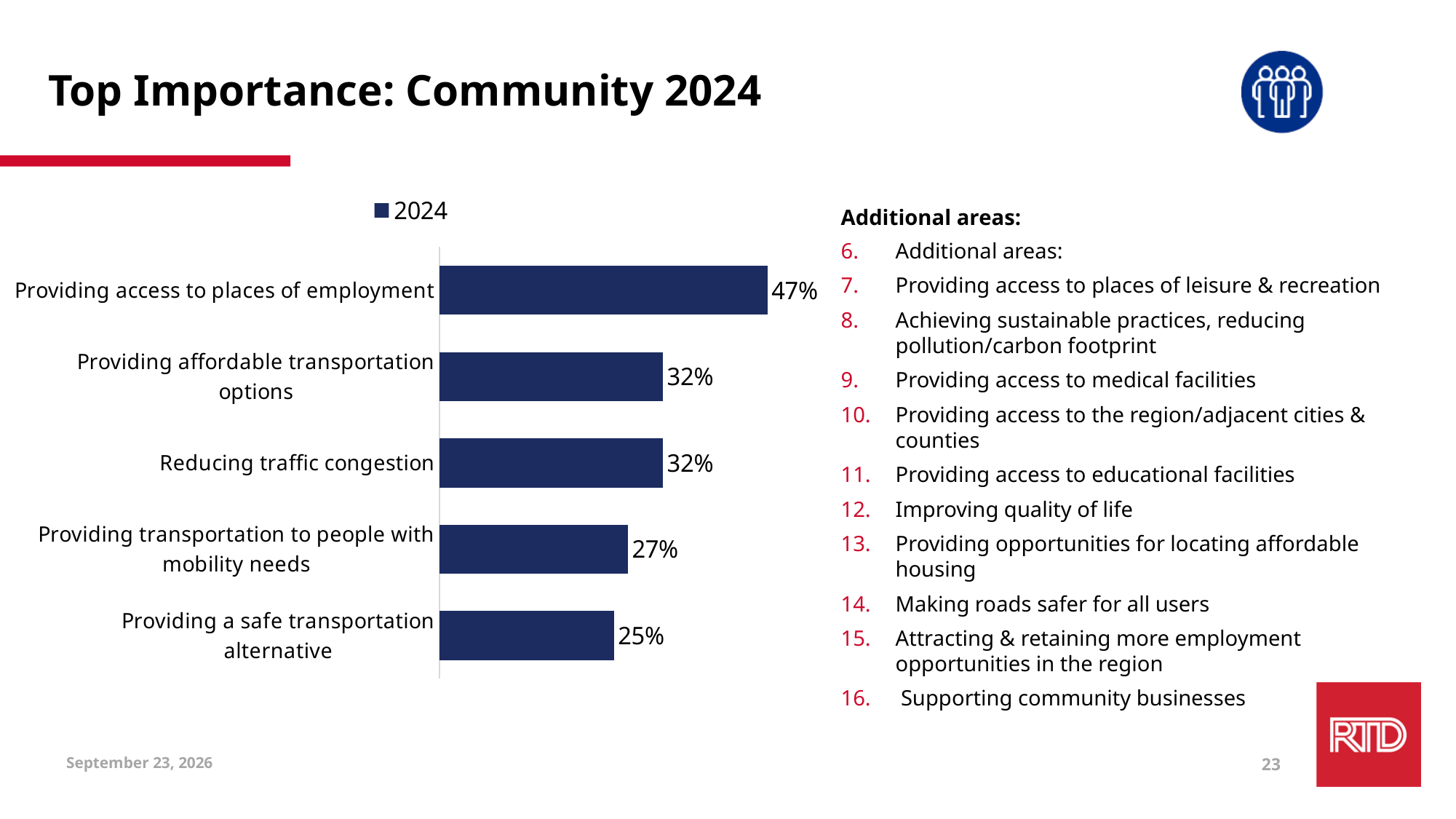
What is the difference between the values for "Providing access to places of employment" and "Providing affordable transportation options"? 15% What is the value for "Providing a safe transportation alternative"? 25% What is the value for "Reducing traffic congestion"? 32% Which category has the lowest value? Providing a safe transportation alternative What is the difference between the values for "Providing transportation to people with mobility needs" and "Providing a safe transportation alternative"? 2% How many series does the legend list? 1 What is the value for "Providing access to places of employment"? 47% What is the value for "Providing transportation to people with mobility needs"? 27% What kind of chart is shown on the slide? Bar chart Which category has the highest value? Providing access to places of employment Which is larger: the value for "Providing access to places of employment" or the value for "Reducing traffic congestion"? Providing access to places of employment How many categories are shown in the chart? 5